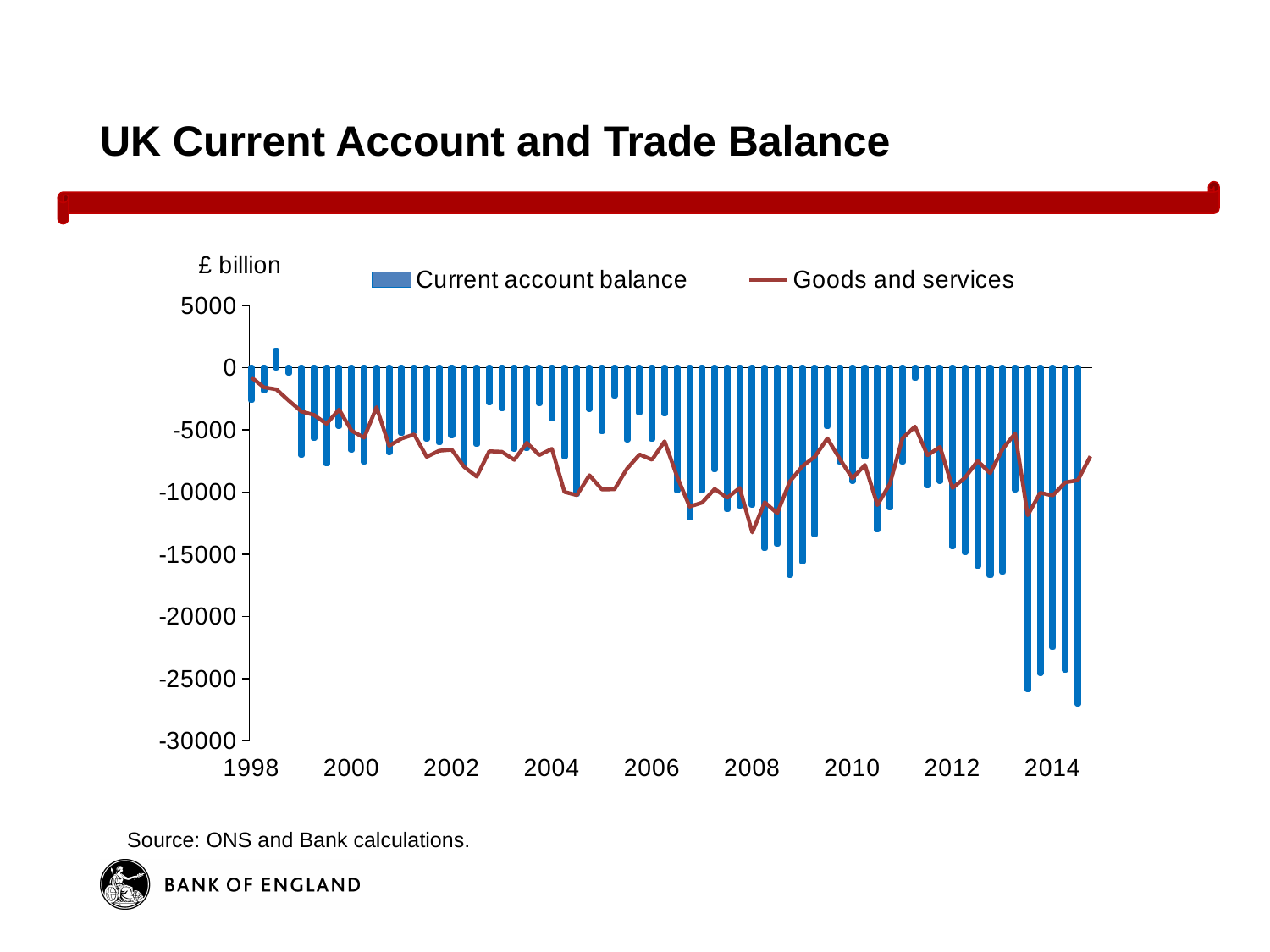
Overall, do the Current account balance bars rise or fall from 1998 to 2014? fall What unit is shown on the vertical axis of the chart? £ billion What kind of chart is shown on the slide? A combined bar and line chart In which year does the Current account balance reach its lowest value? 2014 How many series does the legend list? 2 Is the Current account balance bar at the start of 1998 greater or less than -5000? greater Is the lowest point of the Goods and services line, around 2008, greater or less than -10000? less Is the lowest Current account balance bar, in late 2014, greater or less than -25000? less Which series is plotted as bars, Current account balance or Goods and services? Current account balance In 2014, which series has the lower value, Current account balance or Goods and services? Current account balance What is the title of the chart on the slide? UK Current Account and Trade Balance